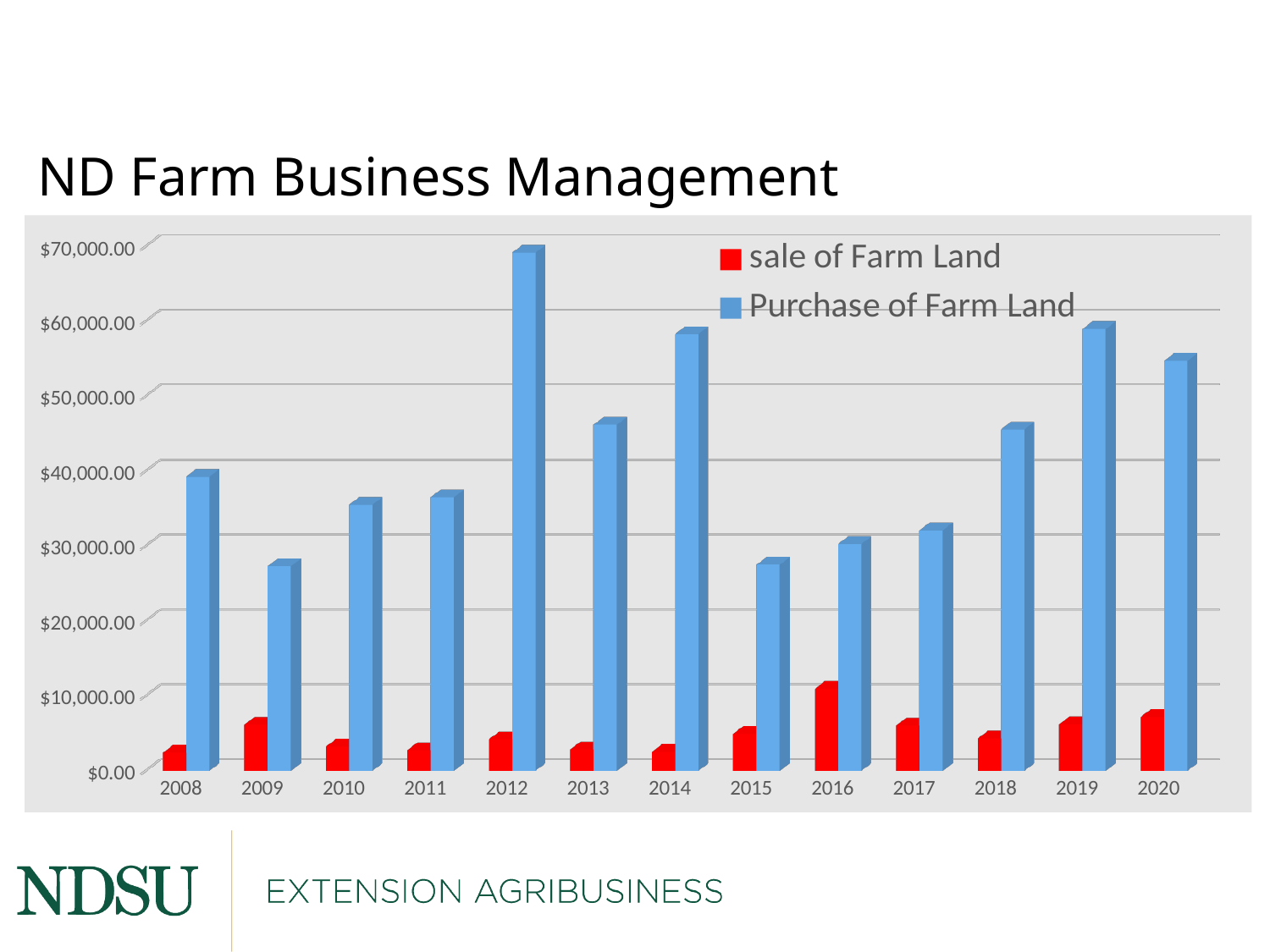
Which year has the larger Purchase of Farm Land value, 2008 or 2009? 2008 How many years are shown along the x axis? 13 Is the Purchase of Farm Land value for 2009 greater or less than $30,000.00? less Is the Purchase of Farm Land value for 2012 greater or less than $60,000.00? greater Is the sale of Farm Land value for 2016 greater or less than $10,000.00? greater Which year has the larger sale of Farm Land value, 2016 or 2009? 2016 Which year has the highest value for Purchase of Farm Land? 2012 Which year has the highest value for sale of Farm Land? 2016 What kind of chart is shown on the slide? Bar chart How many series does the legend list? 2 What colour are the bars for sale of Farm Land? Red